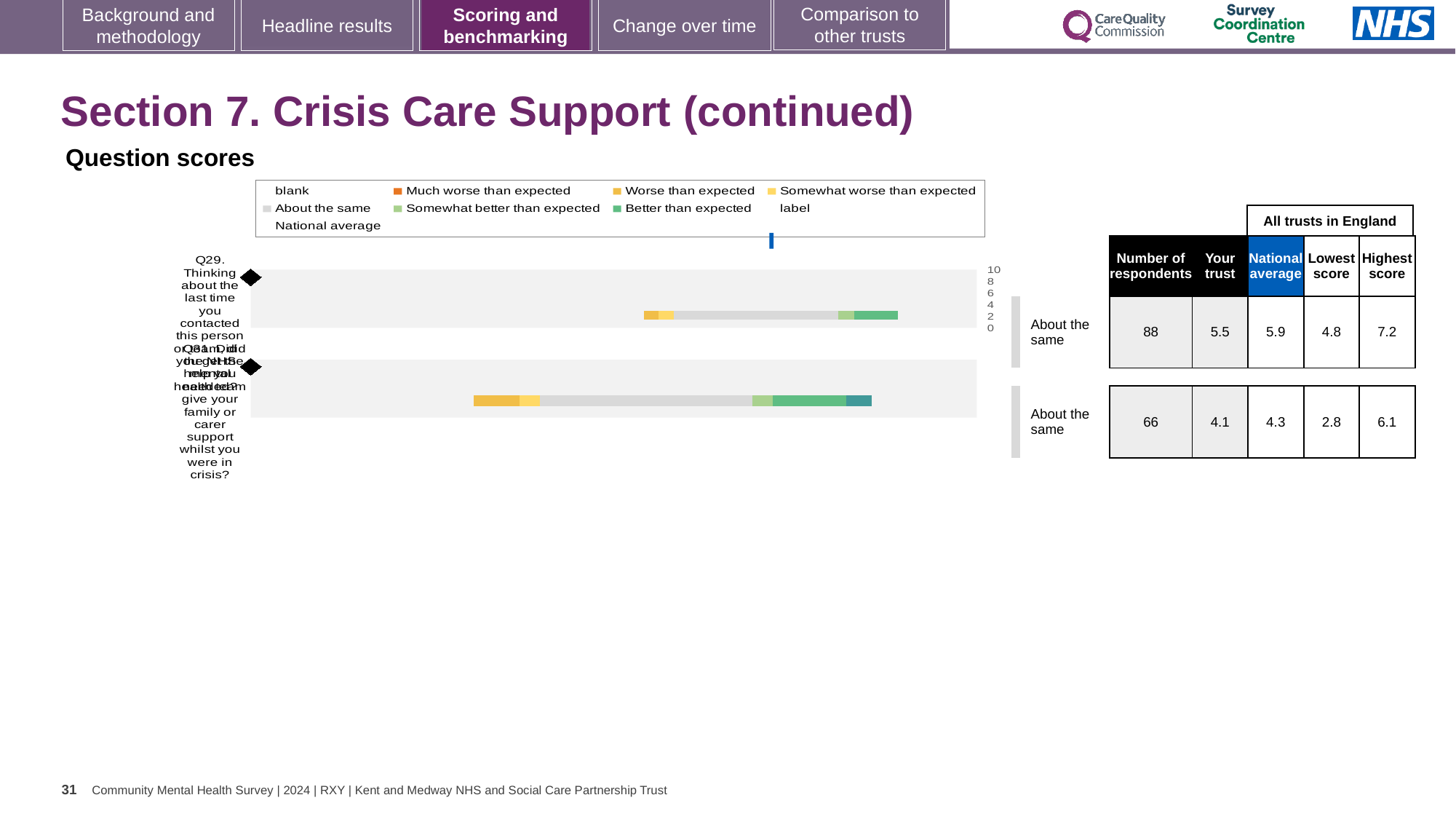
Which benchmark category is shown next to the bar for Q29? About the same For Q29, is the national average higher or lower than the 'Your trust' score? higher In the table beside the chart, what is the 'Your trust' score for Q29? 5.5 What type of chart is used to show the question scores? bar chart Which benchmark category is shown next to the bar for Q31? About the same How many questions are plotted in the question scores chart? 2 In the table beside the chart, what is the national average for Q31? 4.3 In the table beside the chart, how many respondents answered Q31? 66 What is the difference between the highest score and the lowest score for Q29? 2.4 In the table beside the chart, what is the highest score for Q29? 7.2 What is the difference between the highest score and the lowest score for Q31? 3.3 Which question has the higher 'Your trust' score, Q29 or Q31? Q29